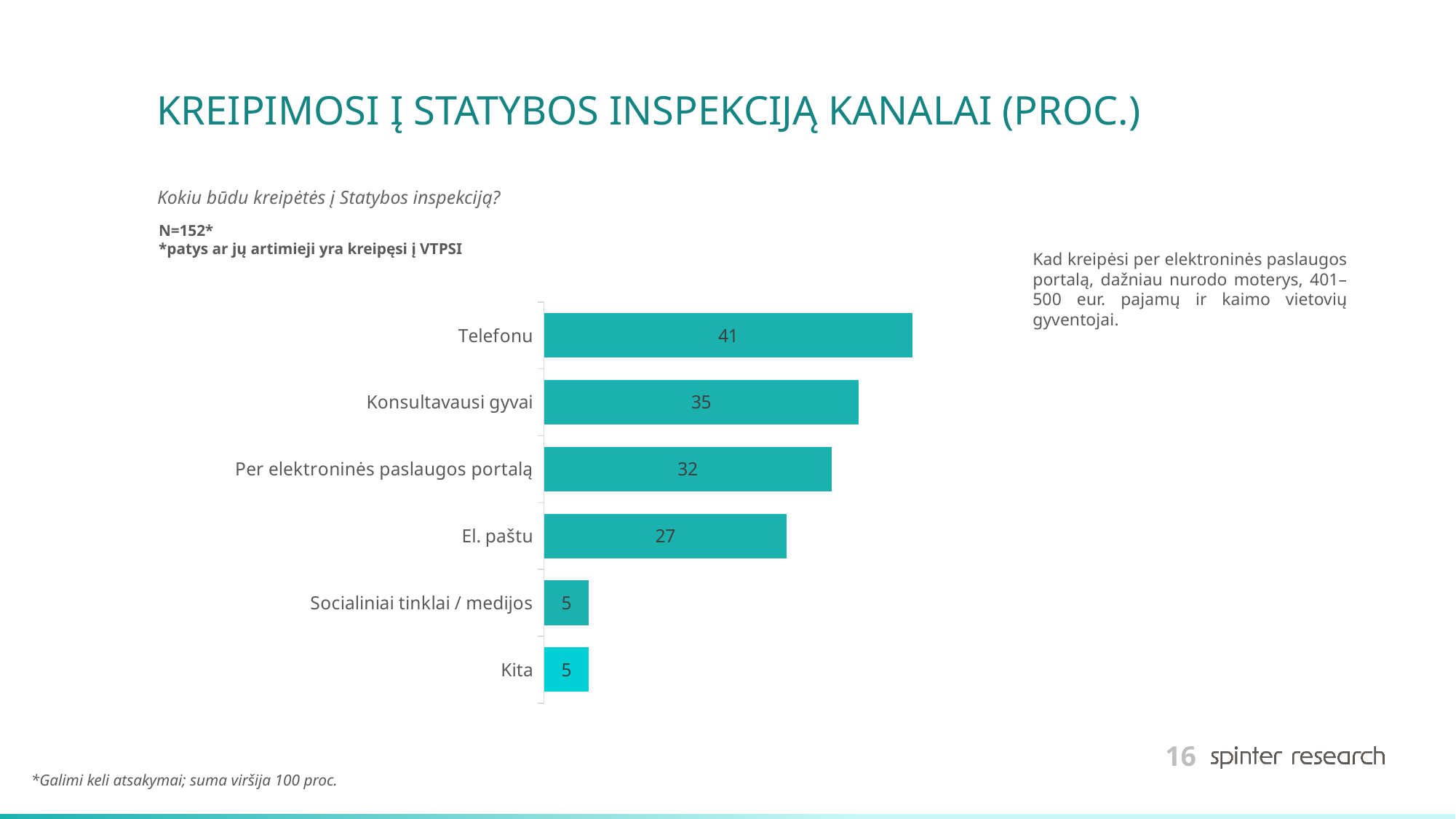
What is the value for Socialiniai tinklai / medijos? 5 What is the value for El. paštu? 27 What is the sample size (N) stated on the slide? 152 Which category has the highest value? Telefonu What is the value for Per elektroninės paslaugos portalą? 32 What is the value for Konsultavausi gyvai? 35 What kind of chart is shown on the slide? Bar chart What is the difference between the values for Telefonu and El. paštu? 14 Which is larger, the value for Konsultavausi gyvai or the value for Per elektroninės paslaugos portalą? Konsultavausi gyvai How many categories are shown in the chart? 6 What is the value for Telefonu? 41 What is the difference between the values for Konsultavausi gyvai and Socialiniai tinklai / medijos? 30